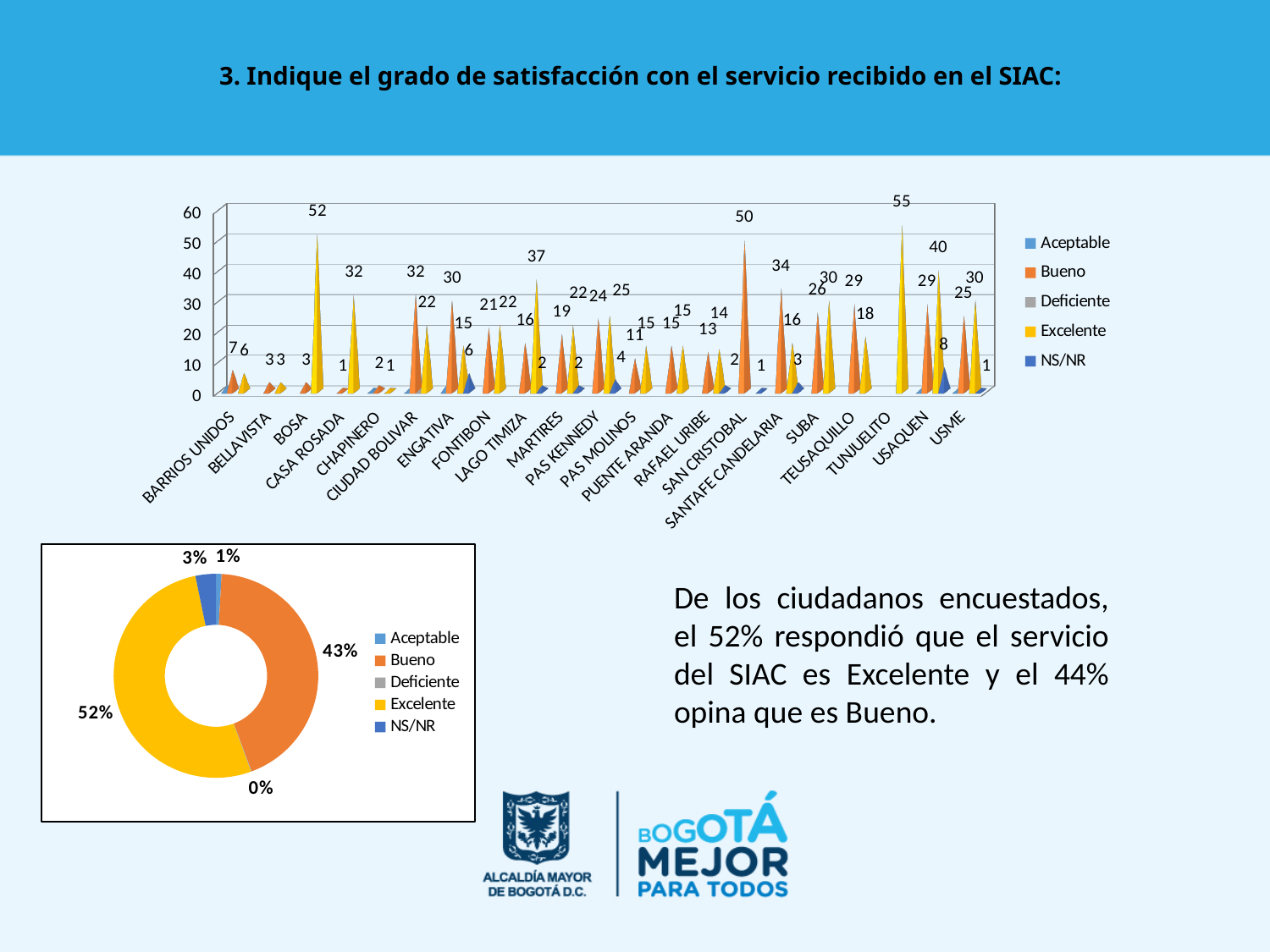
In the top chart, what is the highest value labelled, and for which locality? 55, TUNJUELITO How many localities are shown on the x axis of the top chart? 21 In the doughnut chart, which category has the largest slice? Excelente In the top chart, what is the Excelente value for BOSA? 52 In the doughnut chart, what share of respondents rated the service Excelente? 52% In the doughnut chart, what share of respondents rated the service Bueno? 43% In the doughnut chart, what percentage corresponds to NS/NR? 3% How many categories does the legend of the doughnut chart list? 5 In the doughnut chart, what is the difference in percentage points between Excelente and Bueno? 9% In the doughnut chart, what percentage corresponds to Deficiente? 0% In the top chart, what is the Bueno value for SAN CRISTOBAL? 50 What type of chart is the top chart on the slide? Bar chart